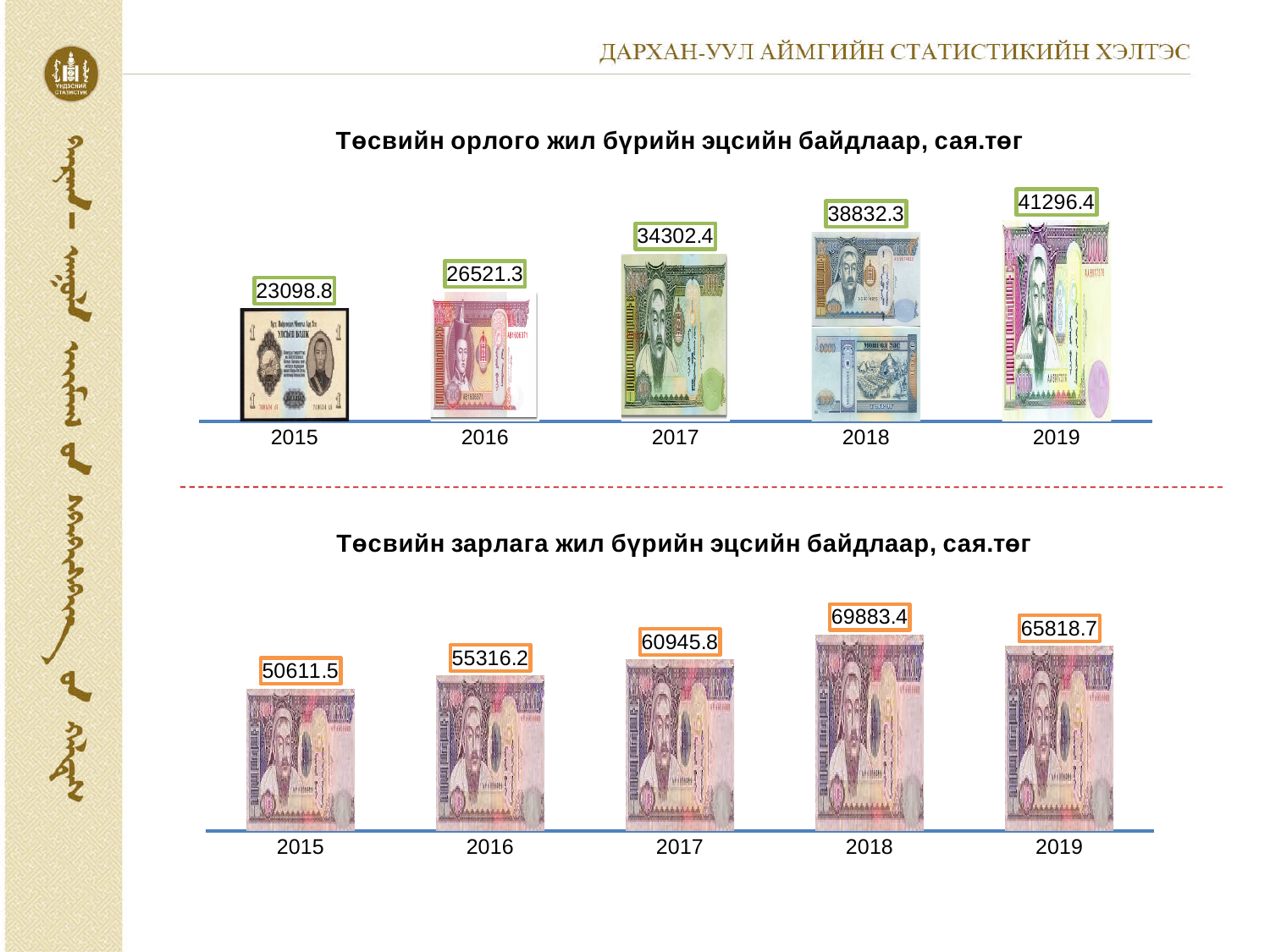
How many years are shown in the bottom chart (Төсвийн зарлага)? 5 In the bottom chart (Төсвийн зарлага), which year has the lowest value? 2015 In the top chart (Төсвийн орлого), do the values rise or fall from 2015 to 2019? rise In the top chart (Төсвийн орлого), which year has the lowest value? 2015 In the top chart (Төсвийн орлого), which year has the highest value? 2019 In the bottom chart (Төсвийн зарлага), which year has the highest value? 2018 In the top chart (Төсвийн орлого жил бүрийн эцсийн байдлаар, сая.төг), what is the value for 2017? 34302.4 In the bottom chart (Төсвийн зарлага жил бүрийн эцсийн байдлаар, сая.төг), what is the value for 2016? 55316.2 In the bottom chart (Төсвийн зарлага), which is larger, the value for 2018 or the value for 2019? 2018 In the bottom chart (Төсвийн зарлага), what is the difference between the 2018 value and the 2019 value? 4064.7 What kind of chart is the top chart (Төсвийн орлого)? bar chart In the top chart (Төсвийн орлого), what is the difference between the 2019 value and the 2015 value? 18197.6